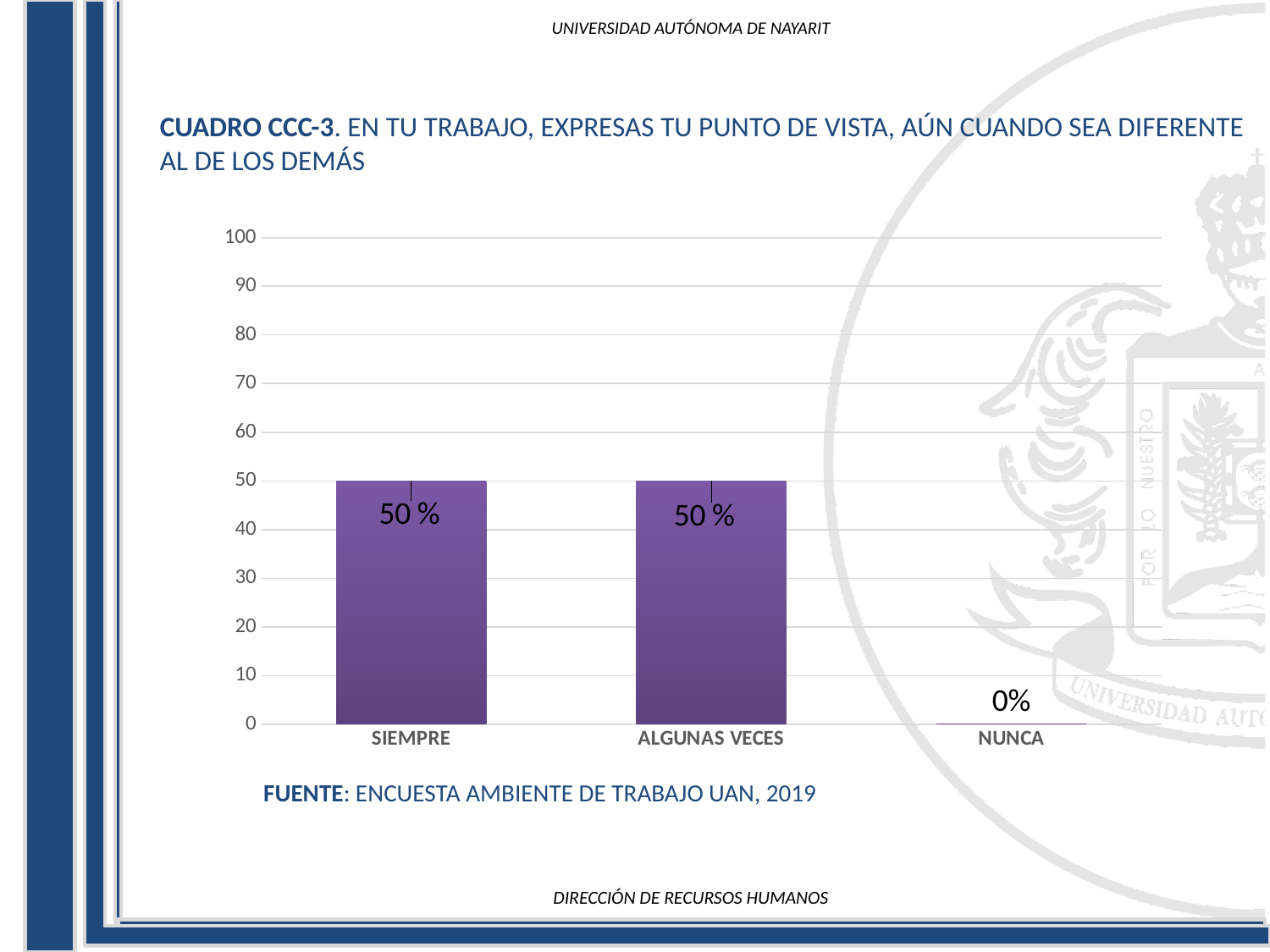
What kind of chart is shown on the slide? bar chart Which category has the lowest value? NUNCA Do the values for SIEMPRE and ALGUNAS VECES differ? No, both are 50 % What is the value for NUNCA? 0% What source is cited below the chart? ENCUESTA AMBIENTE DE TRABAJO UAN, 2019 What is the difference between the value for ALGUNAS VECES and the value for NUNCA? 50 % What is the value for ALGUNAS VECES? 50 % Is the value for NUNCA greater or less than 10? less Which is larger, the value for SIEMPRE or the value for NUNCA? SIEMPRE What is the value for SIEMPRE? 50 % Is the value for SIEMPRE greater or less than 40? greater How many categories are shown on the x axis? 3